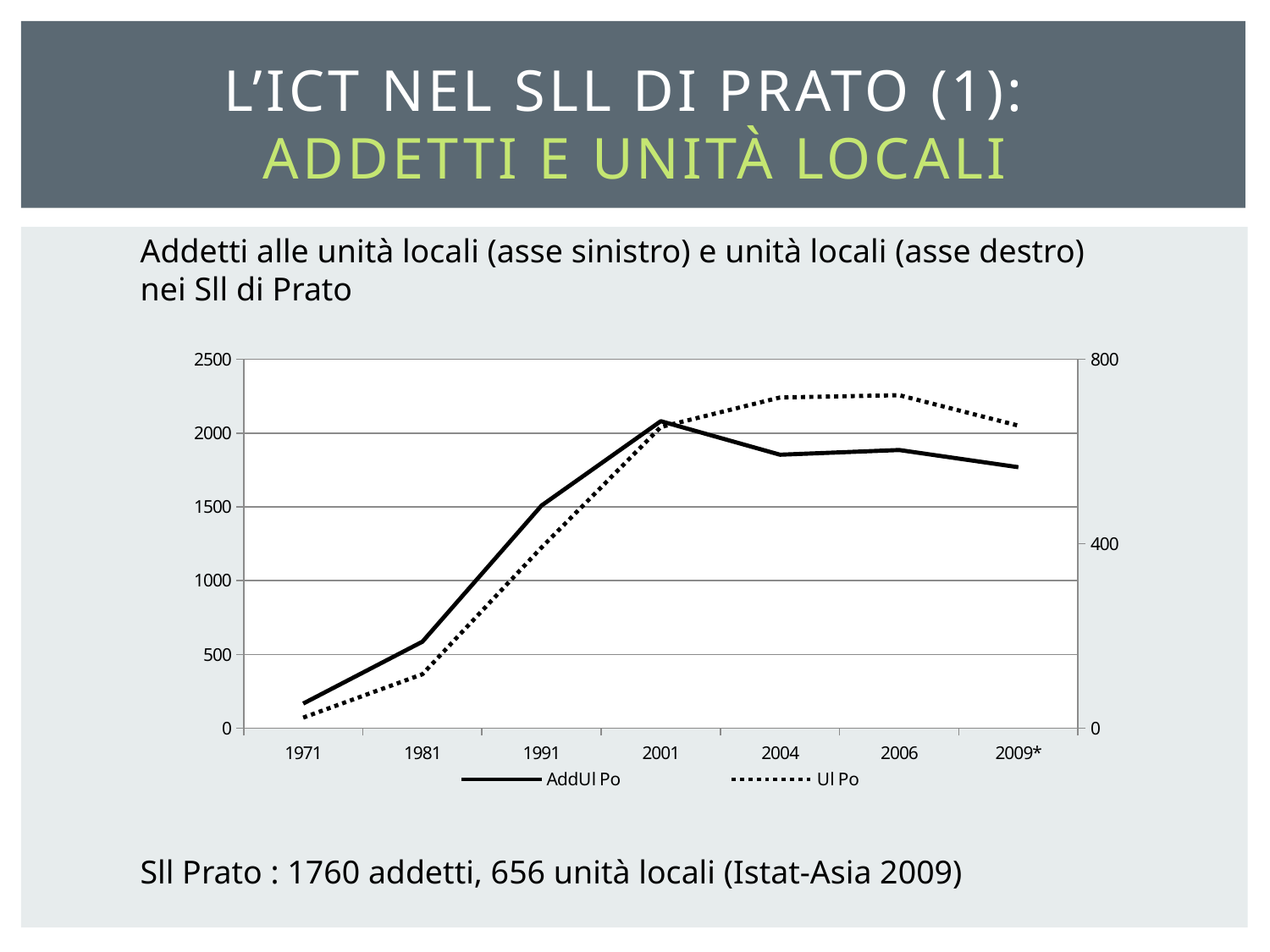
Is the AddUl Po value for 1981 greater or less than 1000? less How many years are plotted along the x axis of the chart? 7 Does the AddUl Po series rise or fall between 2001 and 2009*? fall In which year is the AddUl Po series at its lowest value? 1971 What kind of chart is shown on the slide? line chart Is the Ul Po value for 2004 greater or less than 400 on the right axis? greater Does the AddUl Po series rise or fall between 1971 and 2001? rise Which series is drawn with a dotted line in the chart? Ul Po Is the AddUl Po value for 1991 greater or less than 1000? greater In which year is the Ul Po series at its lowest value? 1971 In which year does the AddUl Po series reach its highest value? 2001 How many series does the chart legend list? 2